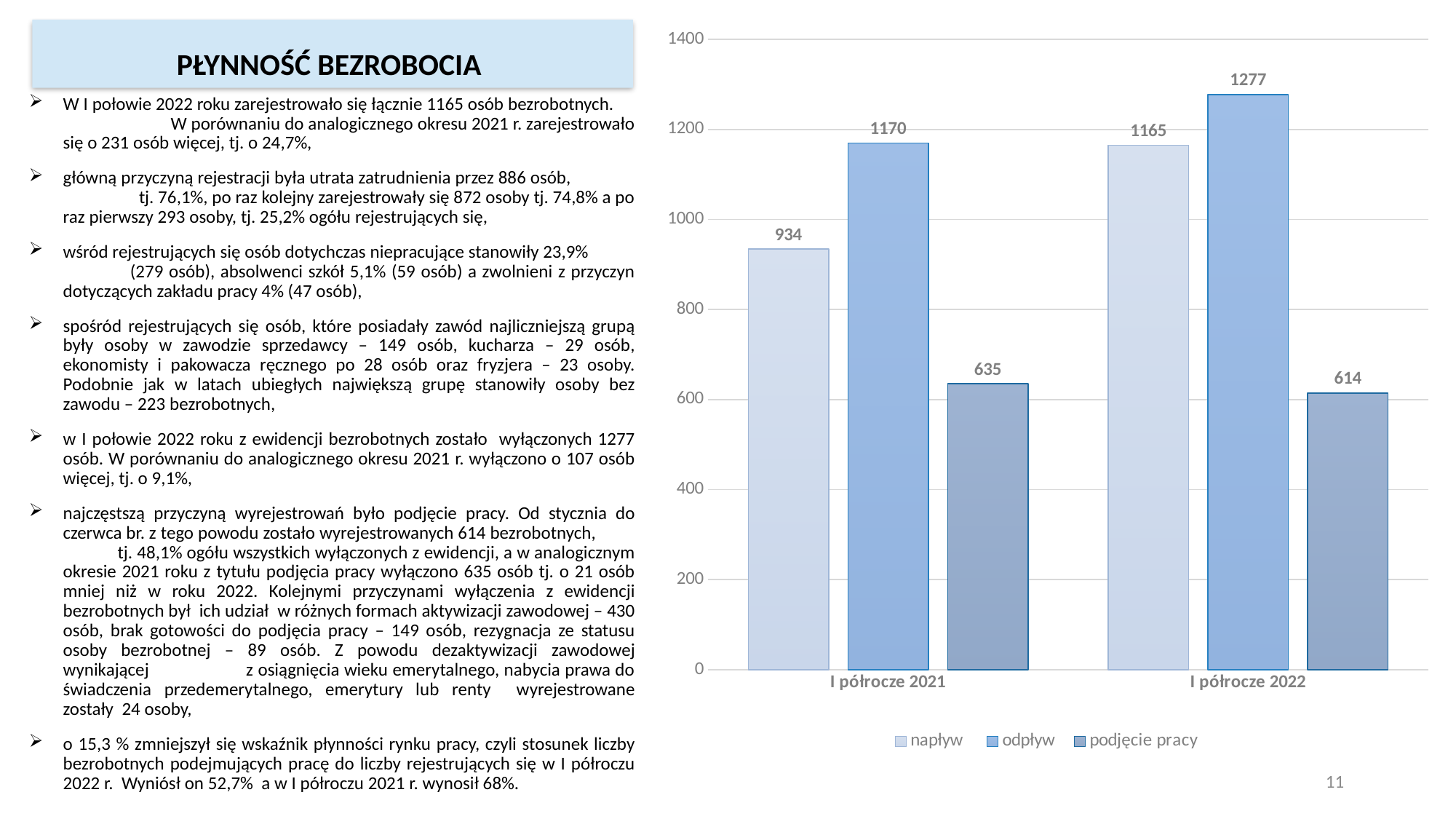
What is the value of podjęcie pracy for I półrocze 2021? 635 Does the napływ value rise or fall from I półrocze 2021 to I półrocze 2022? rise How many series does the legend list? 3 What is the difference between odpływ in I półrocze 2022 and odpływ in I półrocze 2021? 107 How many categories are shown on the x axis? 2 Which is larger: podjęcie pracy in I półrocze 2021 or in I półrocze 2022? I półrocze 2021 What kind of chart is shown on the slide? bar chart Which series has the highest value in I półrocze 2022? odpływ What is the value of napływ for I półrocze 2022? 1165 What is the value of napływ for I półrocze 2021? 934 Which series has the lowest value in I półrocze 2021? podjęcie pracy What is the value of odpływ for I półrocze 2022? 1277